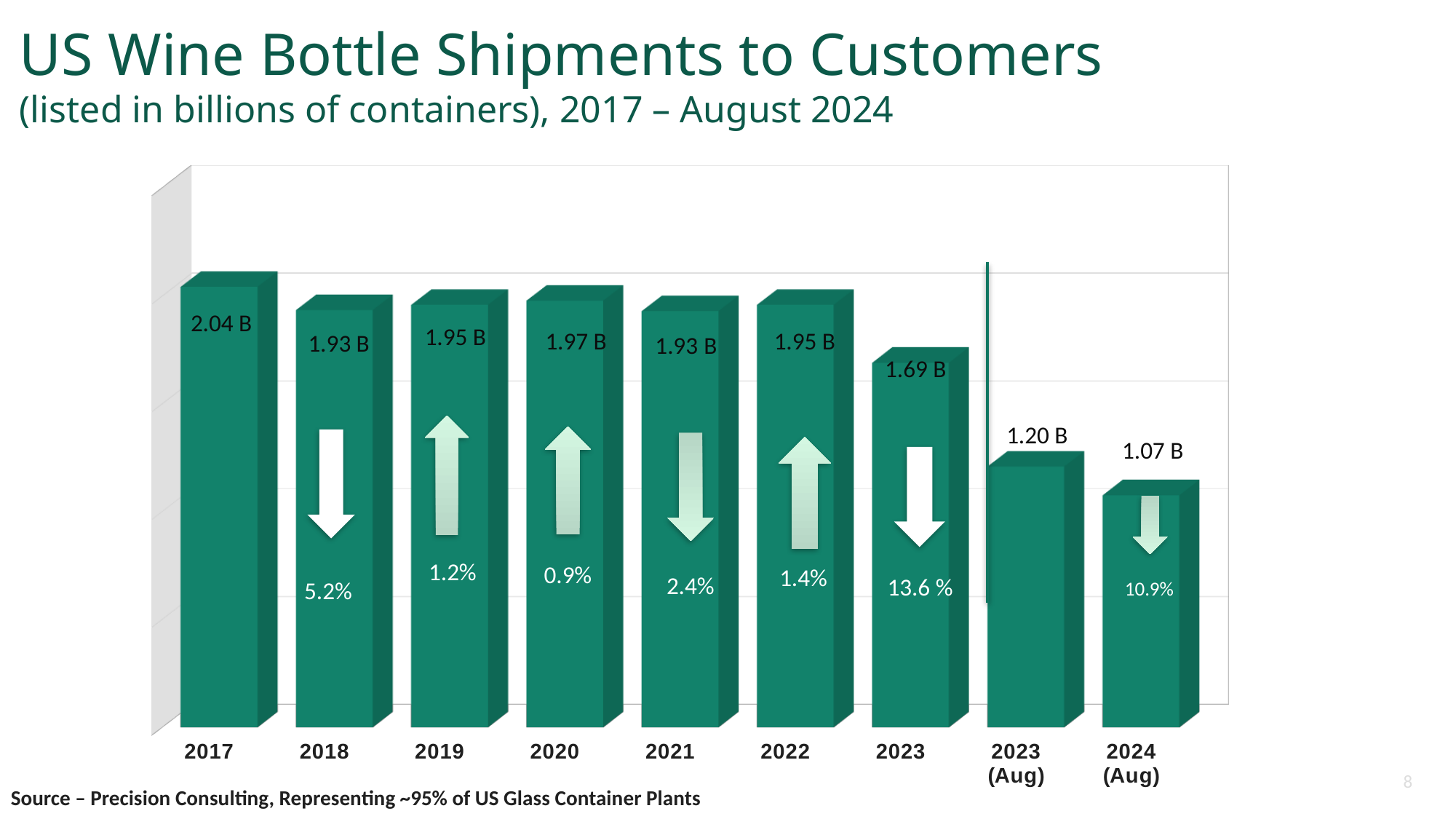
How many bars are shown in the chart? 9 What percentage change is shown on the 2023 bar? 13.6 % What is the difference in shipments between 2017 and 2023? 0.35 B Which bar shows the lowest wine bottle shipments? 2024 (Aug) What kind of chart is shown on the slide? Bar chart What is the difference in shipments between 2023 (Aug) and 2024 (Aug)? 0.13 B Which is larger, the shipments in 2020 or in 2021? 2020 What was the value of US wine bottle shipments in 2017? 2.04 B What was the value of US wine bottle shipments in 2020? 1.97 B What was the value of US wine bottle shipments for 2024 (Aug)? 1.07 B Did shipments rise or fall from 2022 to 2023? Fall Which year has the highest wine bottle shipments? 2017